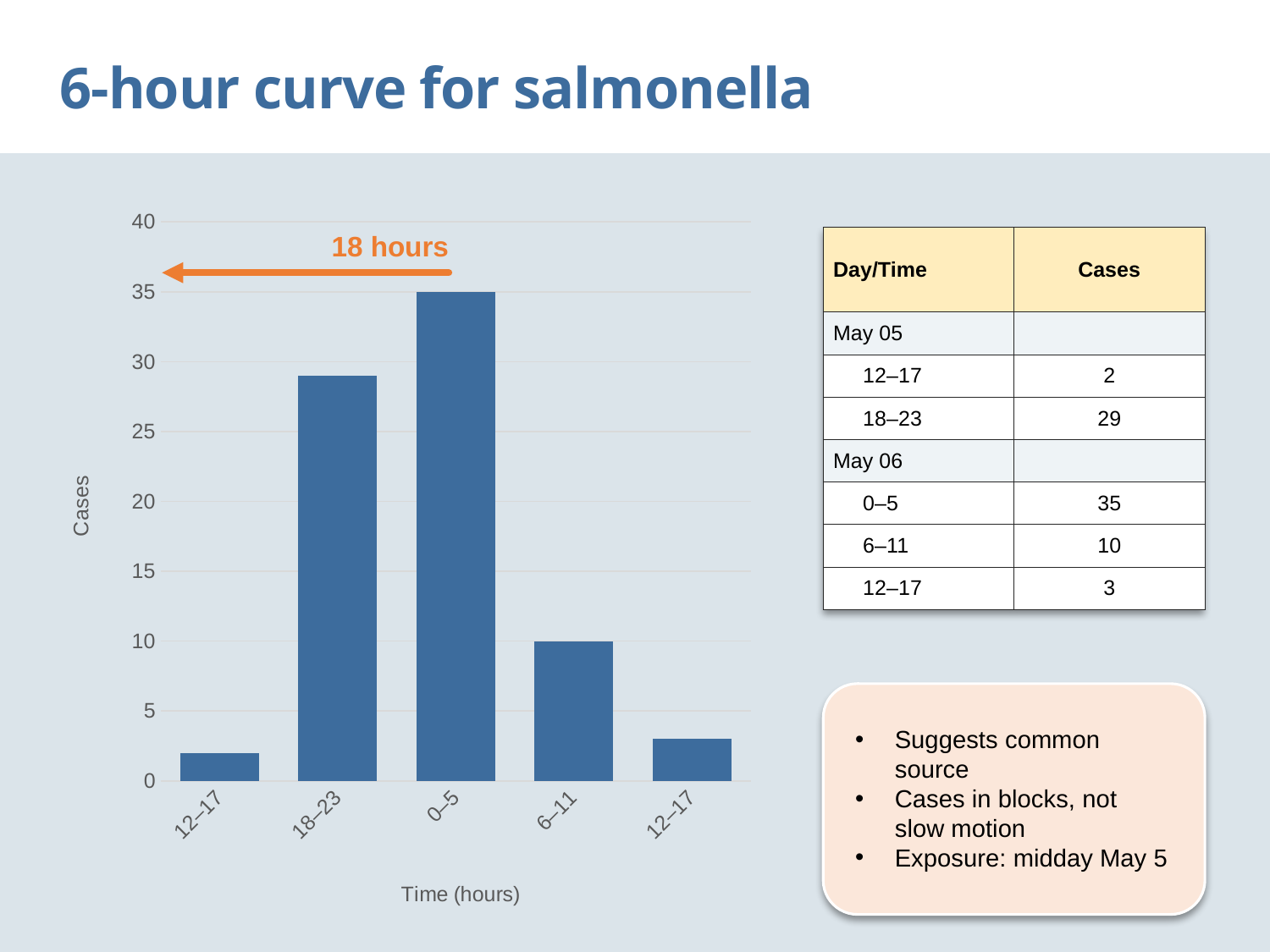
Is the value for the 18–23 block greater or less than 25? greater How many cases are in the 18–23 time block? 29 Which time block has the highest number of cases? 0–5 How many cases are in the 0–5 time block? 35 Which time block has the lowest number of cases? 12–17 (May 05, the first bar) Which has more cases, the 18–23 block or the 6–11 block? 18–23 How many bars are plotted in the chart? 5 How many cases are in the 6–11 time block? 10 What kind of chart is shown on the slide? bar chart How do the case counts change along the x axis from left to right? They rise to a peak at 0–5, then fall What label is written on the orange arrow above the chart? 18 hours What is the difference in cases between the 0–5 block and the 18–23 block? 6